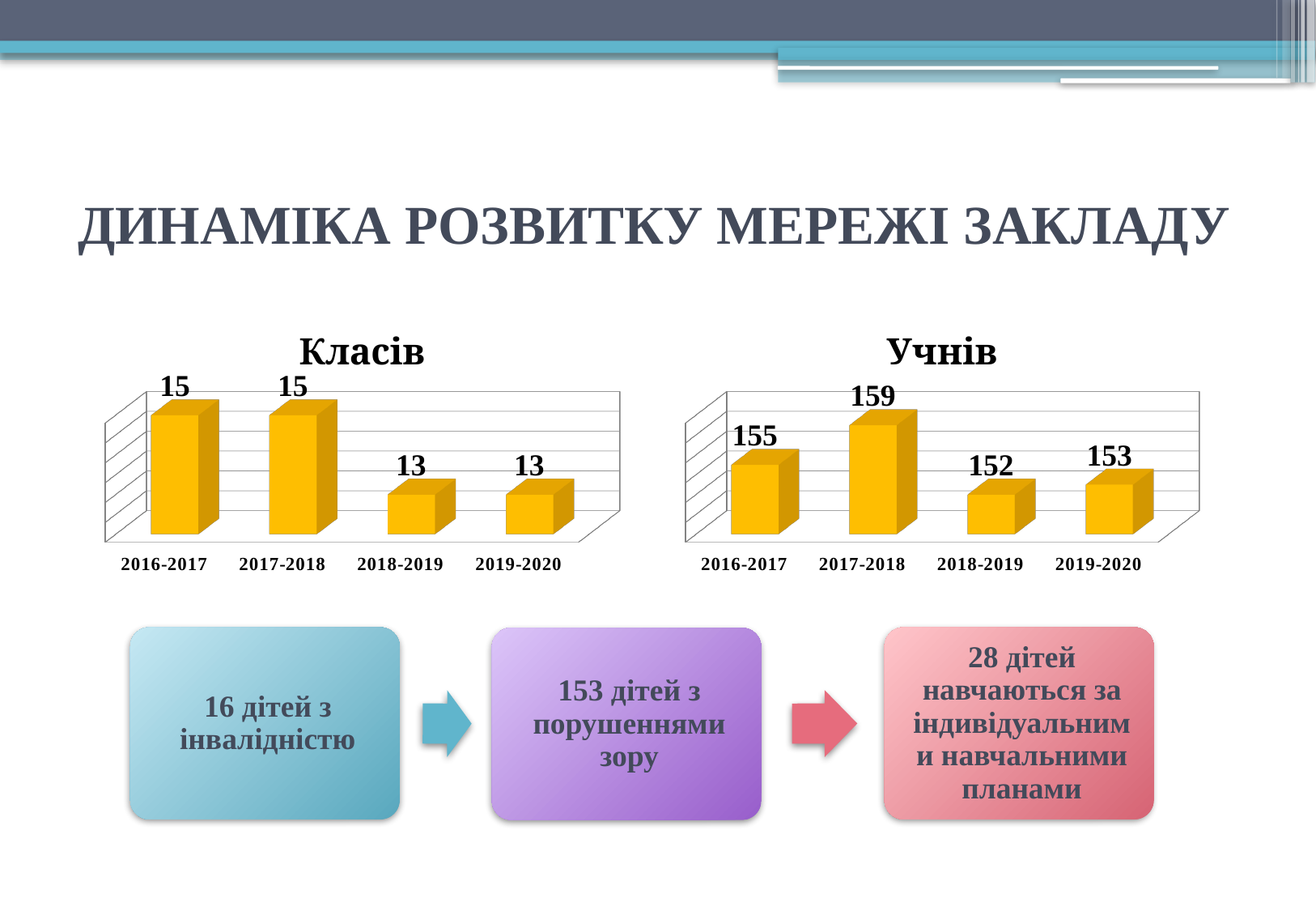
In the "Учнів" chart, which year has the lowest value? 2018-2019 What kind of chart is the "Учнів" chart? bar chart How many categories are shown in the "Класів" chart? 4 In the "Учнів" chart, which year has the highest value? 2017-2018 In the "Класів" chart, what is the value for 2019-2020? 13 In the "Класів" chart, what is the value for 2016-2017? 15 In the "Учнів" chart, what is the value for 2017-2018? 159 In the "Учнів" chart, what is the value for 2018-2019? 152 In the "Учнів" chart, what is the difference between the values for 2017-2018 and 2018-2019? 7 In the "Класів" chart, do the values rise or fall from 2017-2018 to 2018-2019? fall In the "Класів" chart, what is the difference between the values for 2017-2018 and 2018-2019? 2 In the "Учнів" chart, which is larger: the value for 2016-2017 or the value for 2019-2020? 2016-2017